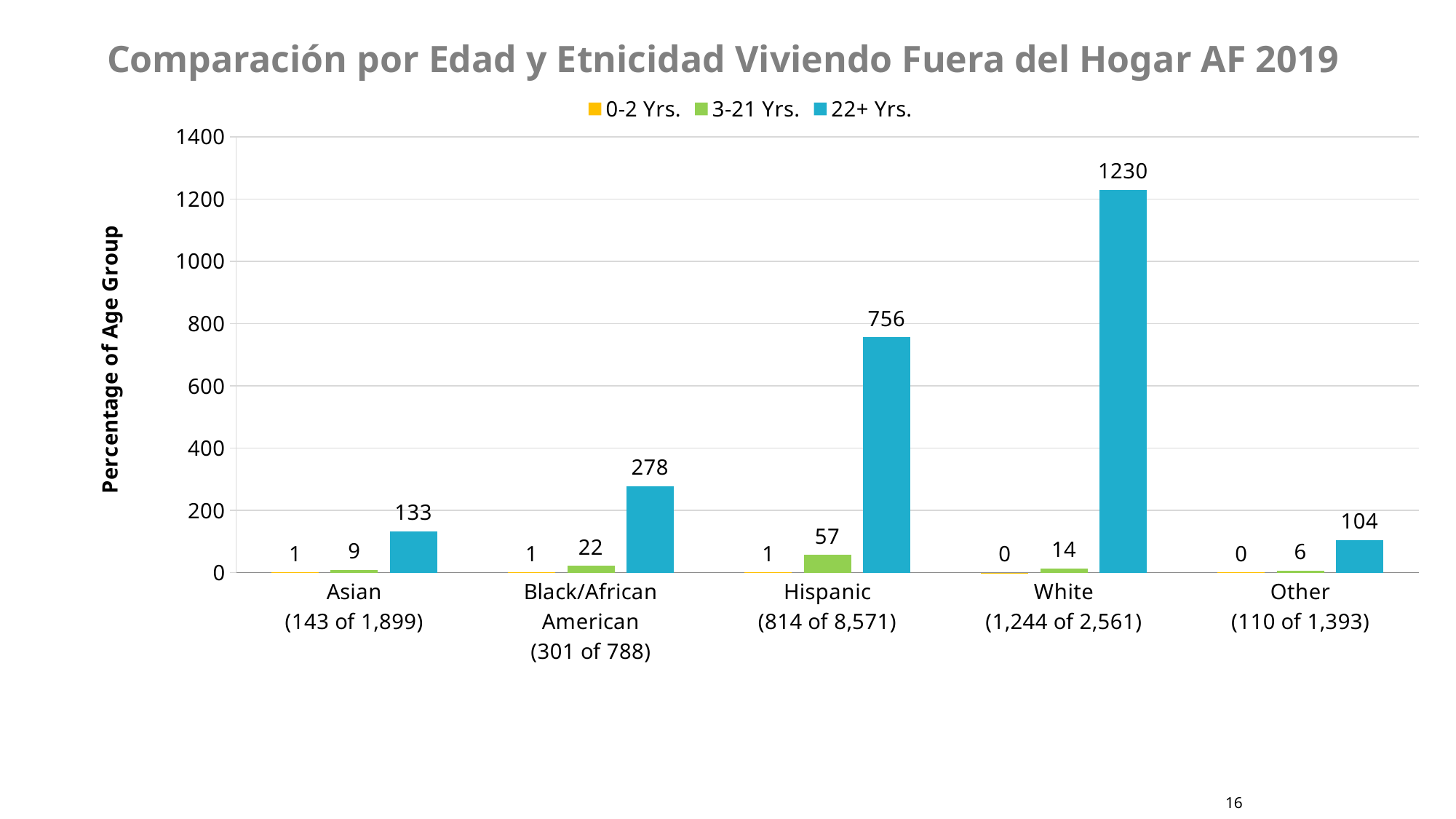
What is the title of the chart? Comparación por Edad y Etnicidad Viviendo Fuera del Hogar AF 2019 How many categories are shown on the x axis? 5 Which is larger: the 3-21 Yrs. value for Black/African American or for White? Black/African American What is the value for 3-21 Yrs. in the Hispanic category? 57 Is the value for 22+ Yrs. in the Hispanic category greater or less than 600? greater What is the difference between the 22+ Yrs. values for Hispanic and Asian? 623 What kind of chart is shown on the slide? bar chart What is the value for 22+ Yrs. in the White category? 1230 What is the value for 22+ Yrs. in the Black/African American category? 278 Which category has the lowest value for 22+ Yrs.? Other How many series does the legend list? 3 Which category has the highest value for 22+ Yrs.? White